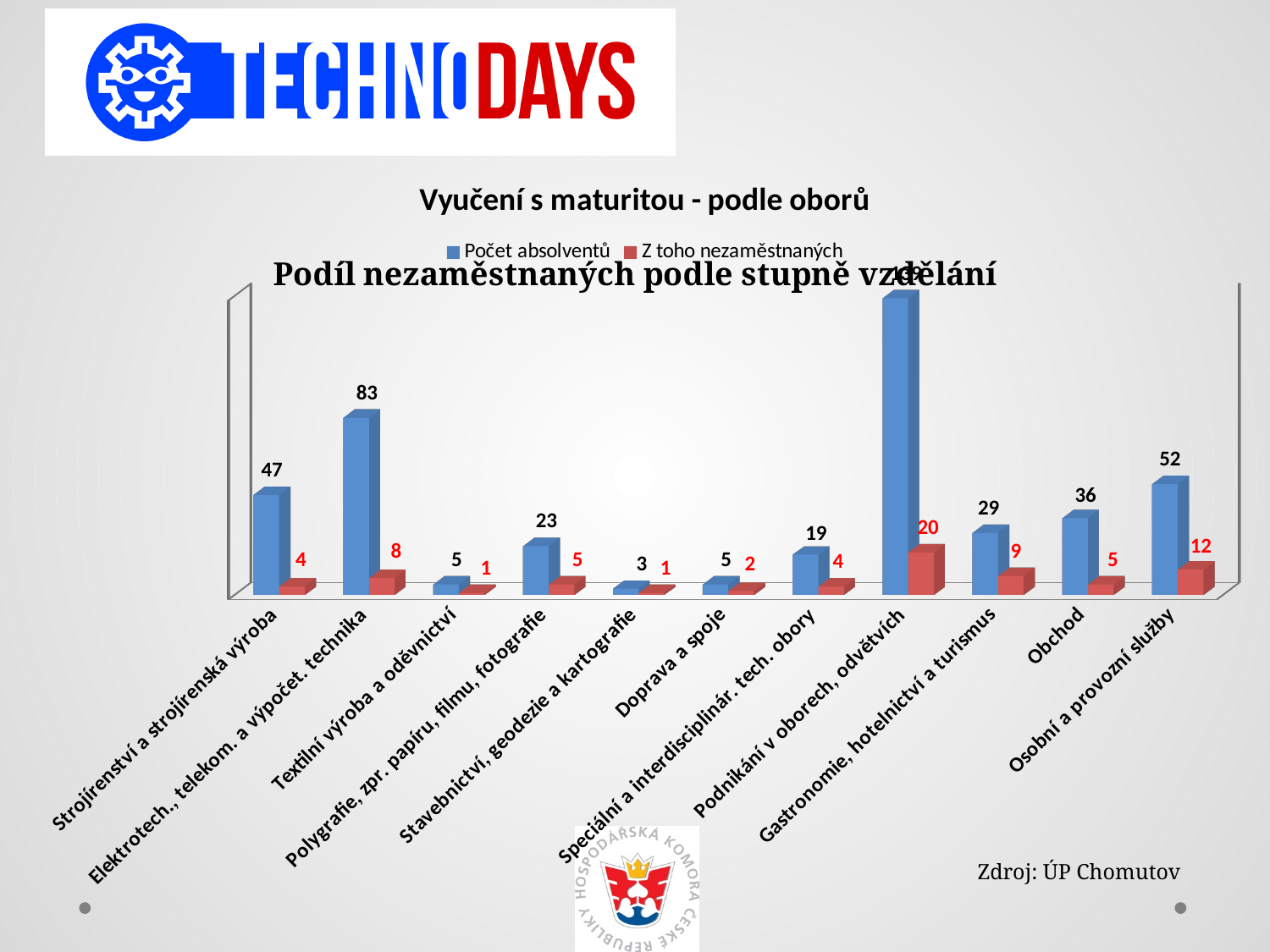
What is the value of Počet absolventů for Gastronomie, hotelnictví a turismus? 29 What is the difference between Počet absolventů and Z toho nezaměstnaných for Strojírenství a strojírenská výroba? 43 Which category has the highest value of Z toho nezaměstnaných? Podnikání v oborech, odvětvích What is the value of Počet absolventů for Elektrotech., telekom. a výpočet. technika? 83 Which category has the lowest value of Počet absolventů? Stavebnictví, geodezie a kartografie How many categories are shown on the x axis? 11 What is the title of the chart? Vyučení s maturitou - podle oborů Which is larger: Počet absolventů for Obchod or for Polygrafie, zpr. papíru, filmu, fotografie? Obchod Which colour represents the series Z toho nezaměstnaných? red What kind of chart is shown? bar chart What is the value of Z toho nezaměstnaných for Osobní a provozní služby? 12 How many series does the legend list? 2